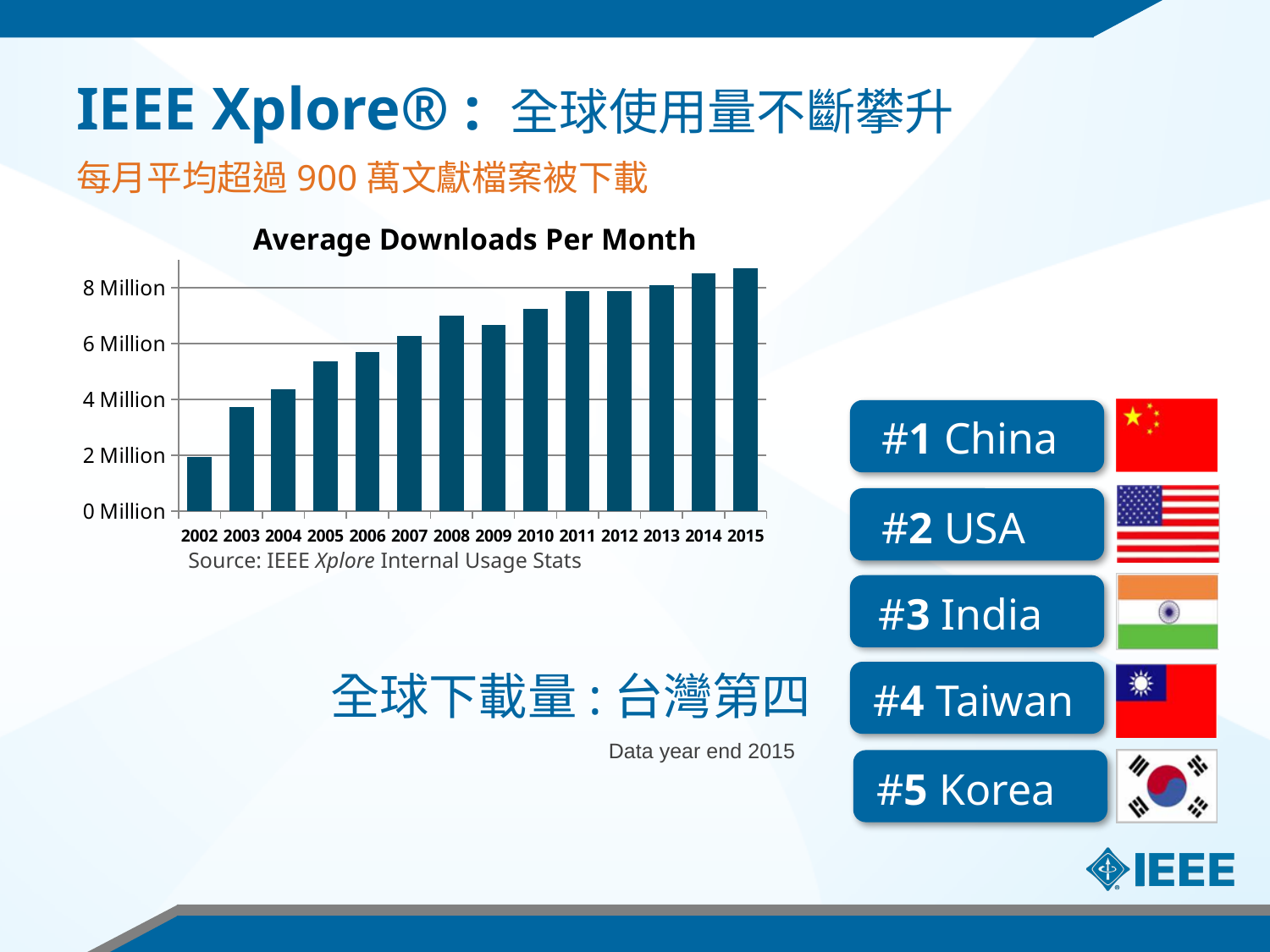
Which year has the highest average downloads per month? 2015 What source is cited below the chart? IEEE Xplore Internal Usage Stats Is the value for 2003 greater or less than 4 Million? less Is the value for 2008 greater or less than 6 Million? greater Do average downloads per month generally rise or fall from 2002 to 2015? rise Which year has the lowest average downloads per month? 2002 What is the title of the chart? Average Downloads Per Month What kind of chart is shown on the slide? bar chart Is the value for 2005 greater or less than 4 Million? greater How many years are plotted in the chart? 14 Which year has the larger value, 2008 or 2009? 2008